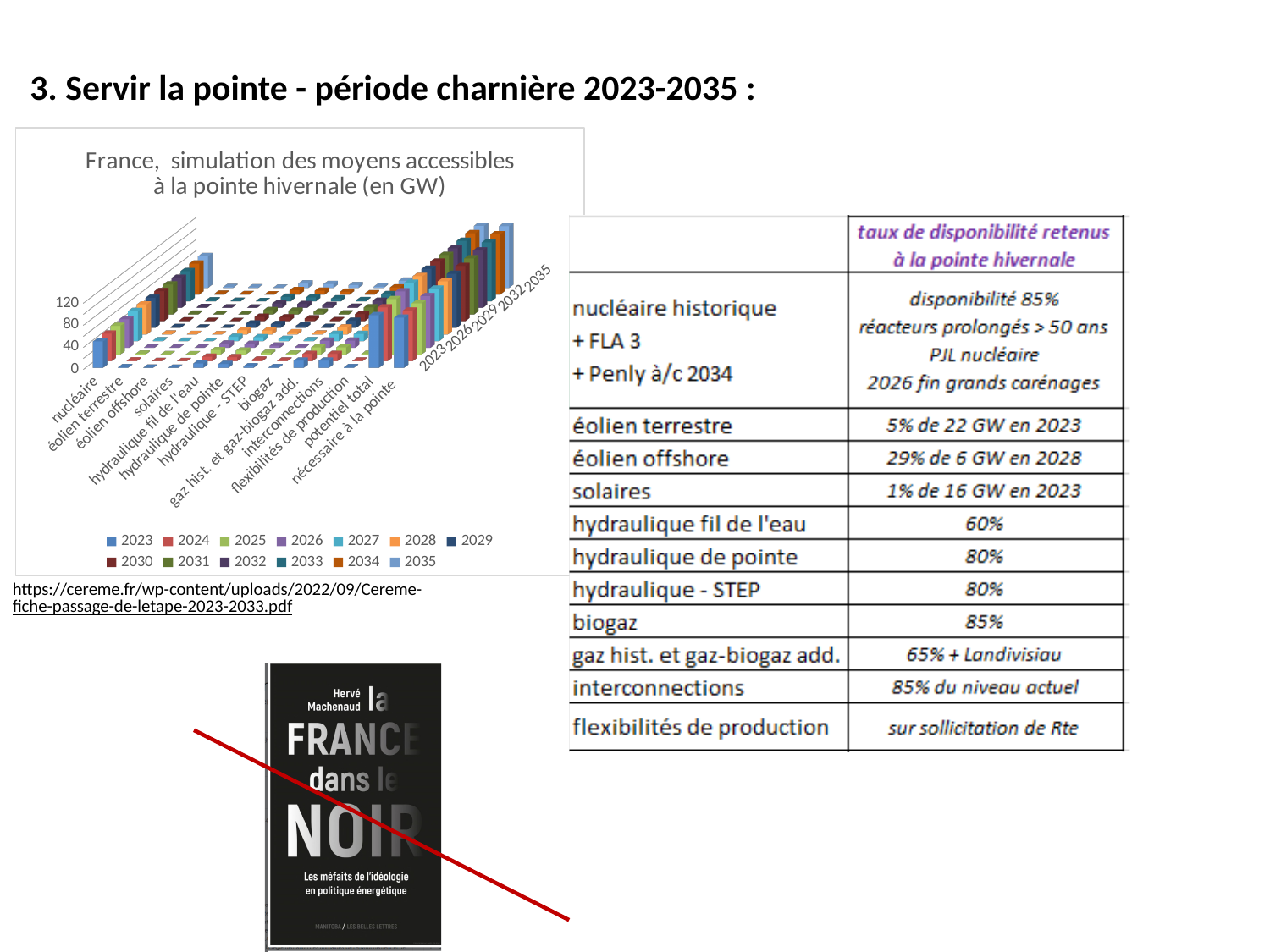
What is the title of the chart? France, simulation des moyens accessibles à la pointe hivernale (en GW) How many series does the chart legend list? 13 Is the value for potentiel total greater or less than 40? greater What kind of chart is shown on the slide? bar chart Which is larger in the chart, the value for nucléaire or the value for éolien offshore? nucléaire Is the value for biogaz greater or less than 40? less Is the value for solaires greater or less than 40? less What is the first year listed in the chart legend? 2023 Which category has the tallest bars in the chart? potentiel total How many categories are shown along the category axis of the chart? 13 Which is larger in the chart, the value for potentiel total or the value for solaires? potentiel total